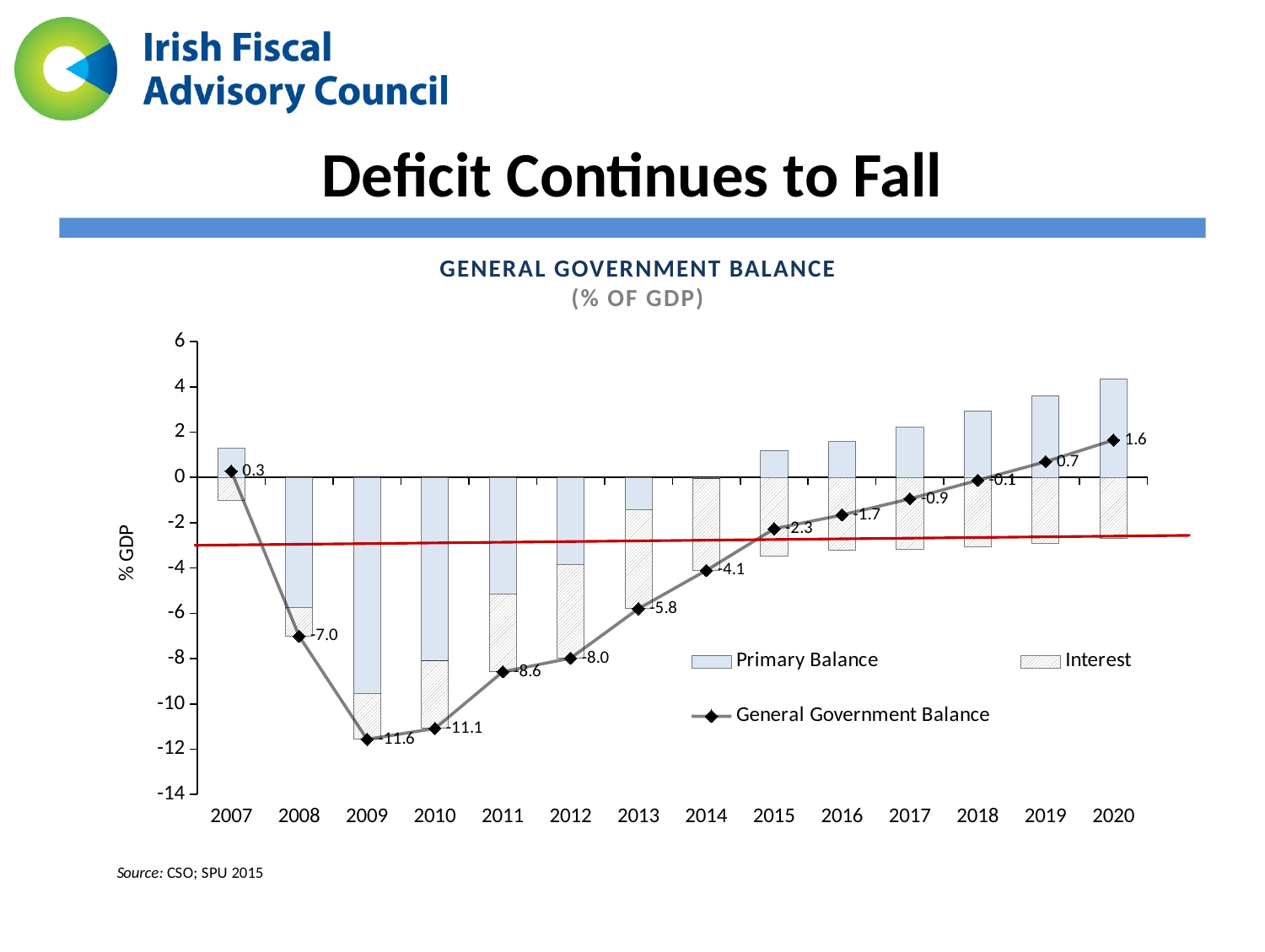
How many years are shown on the x axis? 14 What is the General Government Balance value for 2020? 1.6 Does the General Government Balance rise or fall from 2009 to 2020? rise What is the General Government Balance value for 2009? -11.6 How many series does the legend list? 3 What is the difference between the General Government Balance in 2014 (-4.1) and 2015 (-2.3)? 1.8 What is the difference between the General Government Balance in 2008 (-7.0) and 2009 (-11.6)? 4.6 Which year has a higher General Government Balance, 2011 or 2013? 2013 What is the General Government Balance value for 2014? -4.1 Is the Primary Balance bar for 2020 greater or less than 2? greater In which year is the General Government Balance lowest? 2009 In which year is the General Government Balance highest? 2020